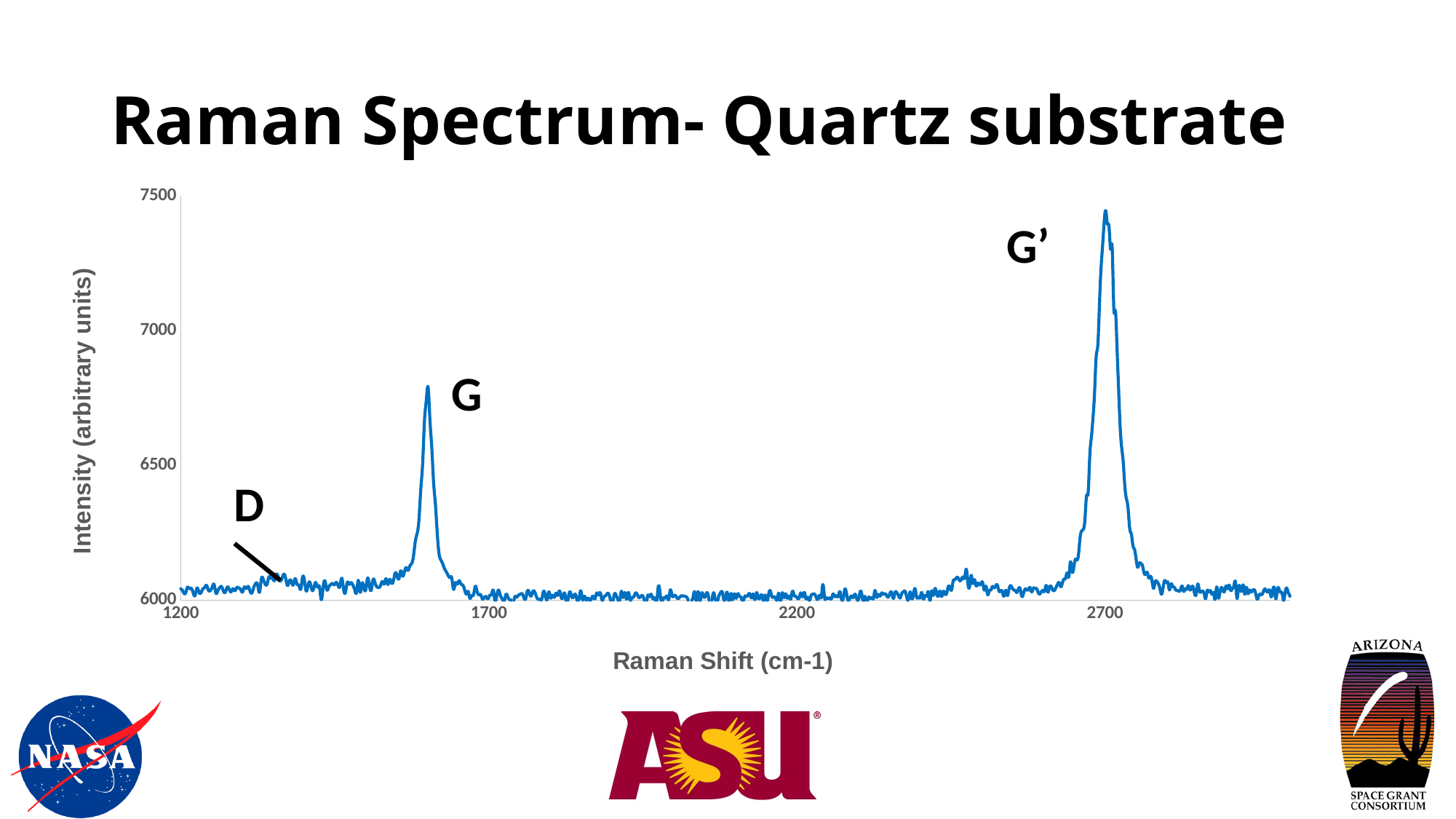
Is the intensity at the D peak greater or less than 6500? less Which labeled peak has the highest intensity? G' What kind of chart is shown on the slide? line chart Which labeled peak has the lowest intensity? D What is the label of the x axis? Raman Shift (cm-1) How many labeled peaks are marked on the spectrum? 3 Is the intensity at the G peak greater or less than 7000? less Is the intensity at the G' peak greater or less than 7000? greater Which peak is taller, G or G'? G' Which peak is taller, D or G? G What is the title of the chart? Raman Spectrum- Quartz substrate